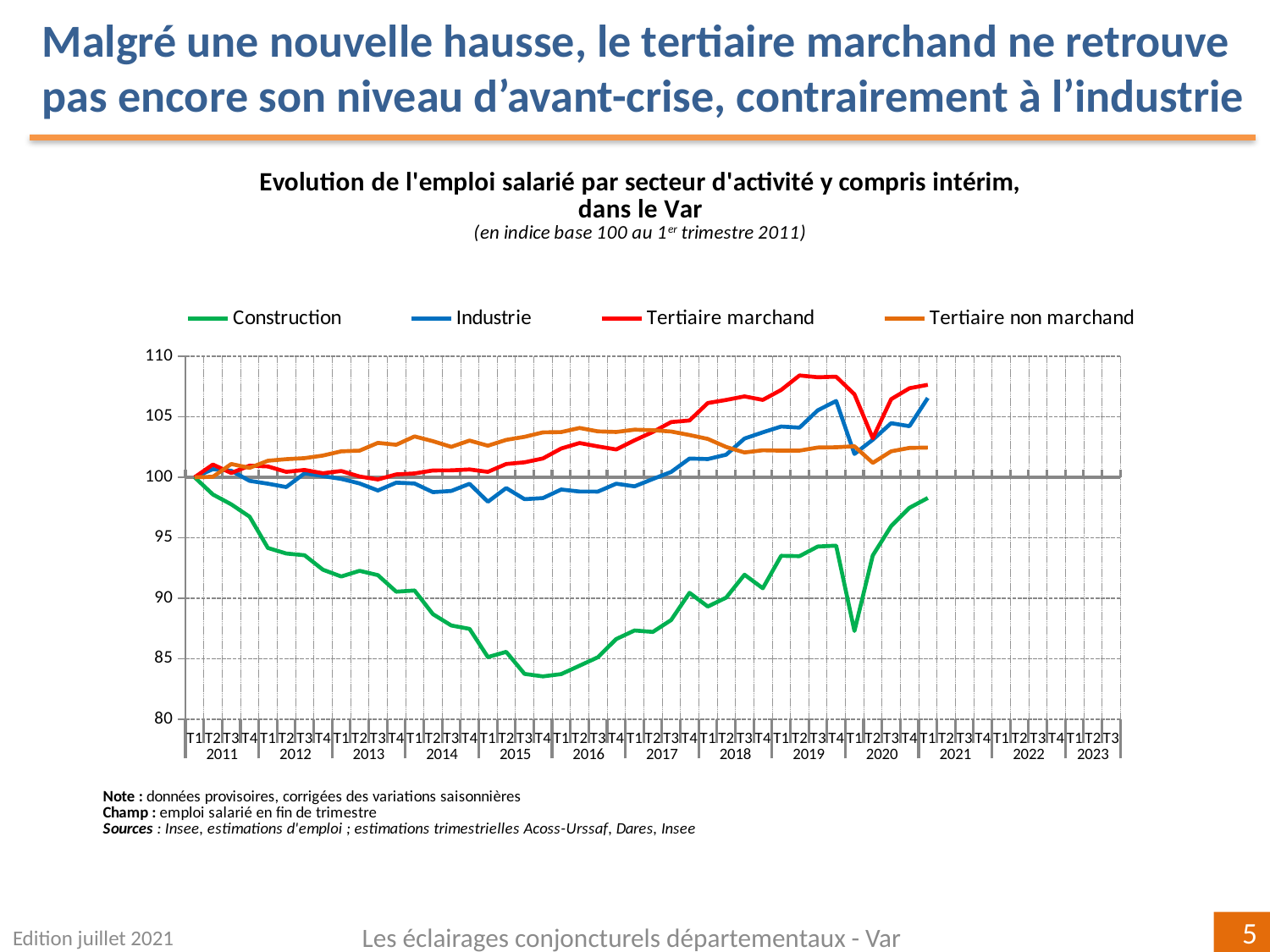
What kind of chart is shown on the slide? Line chart Is the value for Construction at T1 2021 greater or less than 100? less Is the value for Construction at T3 2015 greater or less than 85? less What is the base period of the index used in the chart? 1er trimestre 2011 (base 100) Is the value for Industrie at T1 2021 greater or less than 105? greater How many series does the legend list? 4 Which series has the highest value at T2 2019? Tertiaire marchand Does the Construction series rise or fall between T1 2011 and T3 2015? Fall At T1 2021, which is larger: the value for Tertiaire marchand or the value for Construction? Tertiaire marchand Which series has the lowest value at T1 2021? Construction Which series is plotted in green? Construction